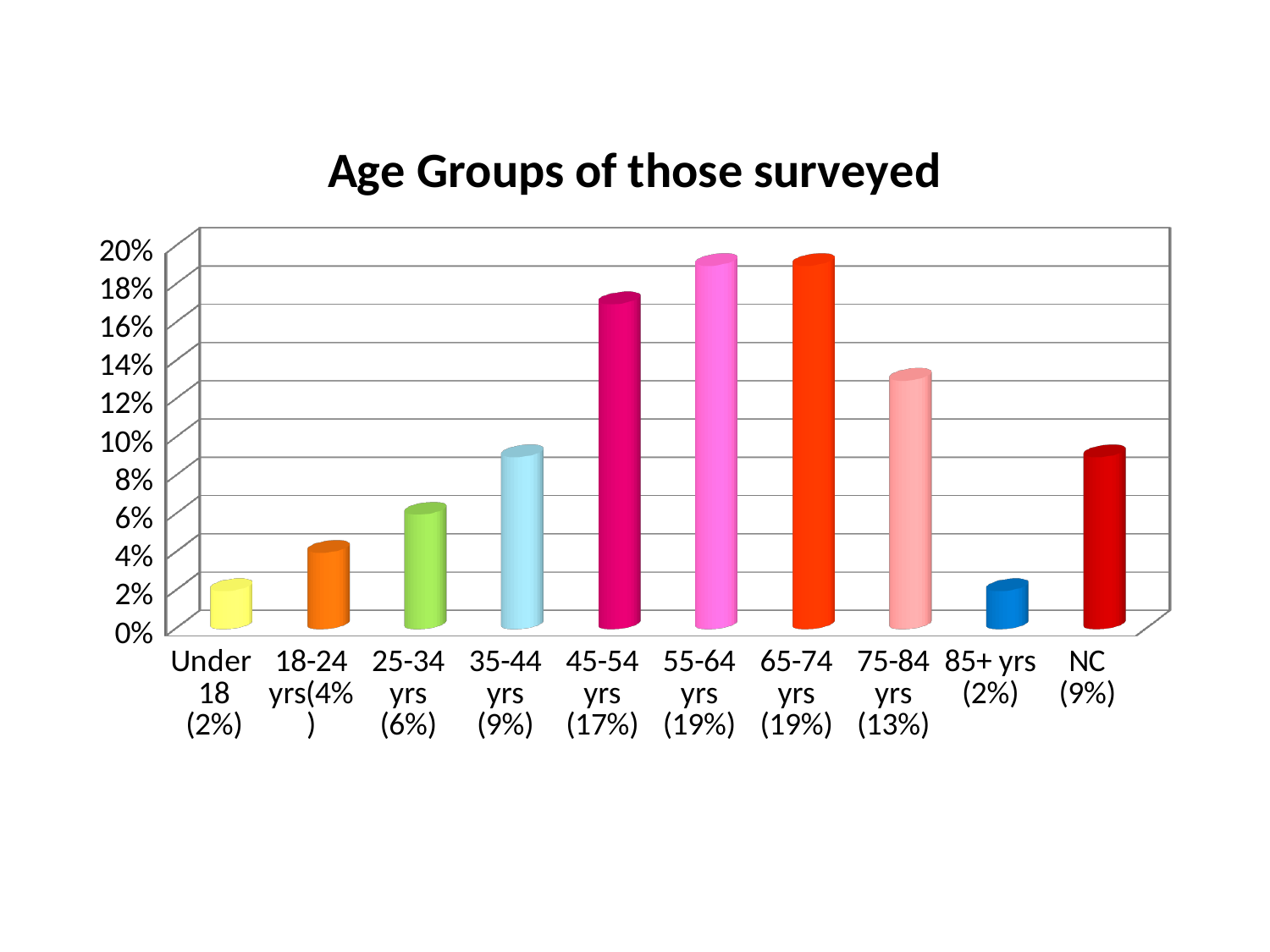
How many age group categories are plotted in the chart? 10 What is the lowest percentage shown for any age group in the chart? 2% Which age group has the larger percentage, 75-84 yrs or 35-44 yrs? 75-84 yrs What is the title of the chart? Age Groups of those surveyed What percentage of those surveyed were in the 18-24 yrs age group? 4% What percentage of those surveyed were in the 75-84 yrs age group? 13% What percentage of those surveyed were in the 45-54 yrs age group? 17% What kind of chart is shown on the slide? Bar chart Is the value for the 65-74 yrs age group greater or less than 10%? greater What percentage of those surveyed were in the 35-44 yrs age group? 9% What is the difference between the percentages for the 45-54 yrs and 25-34 yrs age groups? 11% What is the highest percentage shown for any age group in the chart? 19%